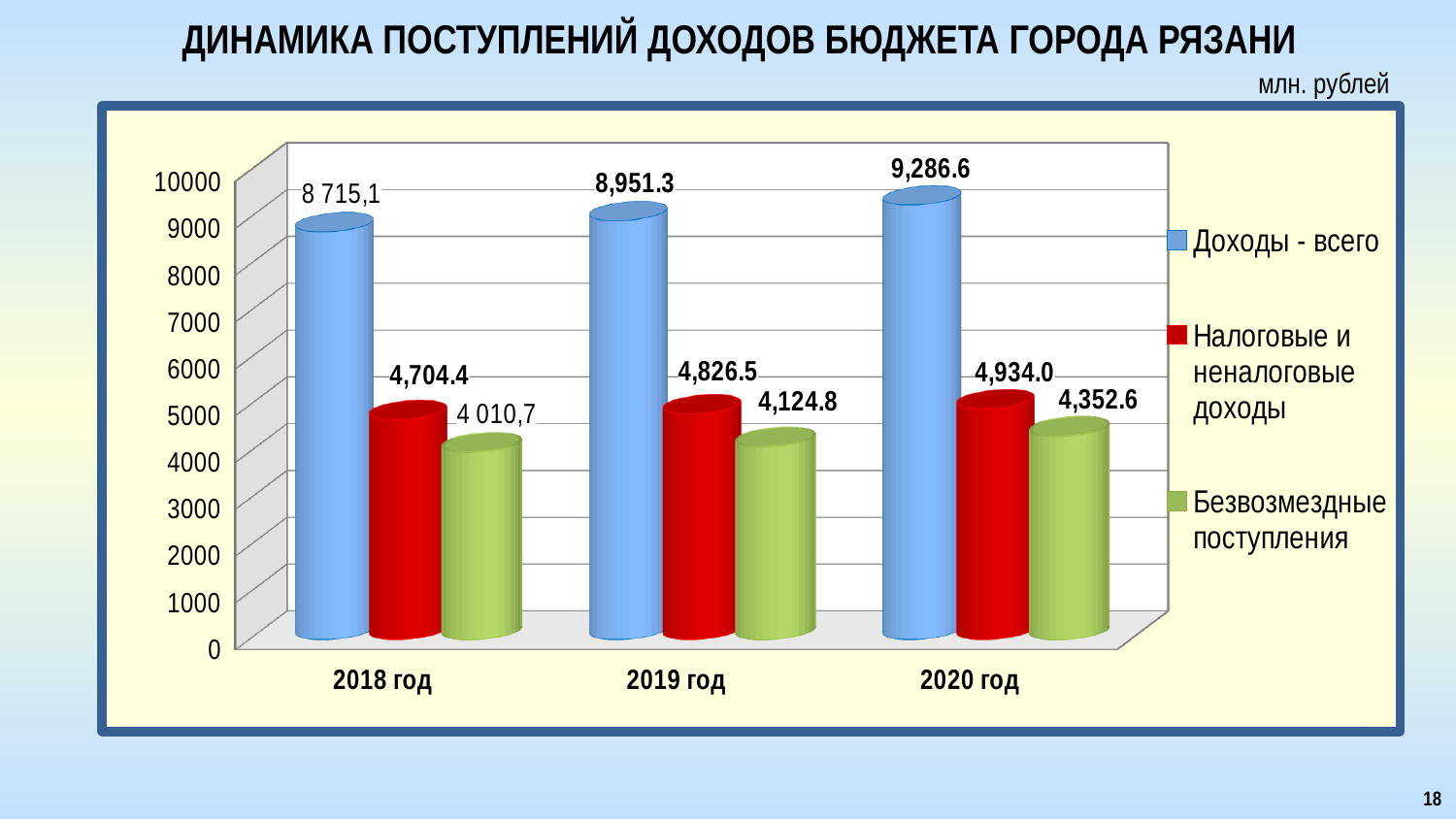
In which year is Безвозмездные поступления the lowest? 2018 год What is the value of Безвозмездные поступления for 2018 год? 4 010,7 How many series does the legend list? 3 Which is larger in 2019 год: Налоговые и неналоговые доходы or Безвозмездные поступления? Налоговые и неналоговые доходы In which year is Доходы - всего the highest? 2020 год What kind of chart is shown on the slide? Bar chart What is the value of Доходы - всего for 2019 год? 8,951.3 What is the difference between Доходы - всего in 2020 год and 2019 год? 335.3 What is the value of Налоговые и неналоговые доходы for 2020 год? 4,934.0 Does Доходы - всего rise or fall from 2018 год to 2020 год? Rise What is the difference between Безвозмездные поступления in 2020 год and 2019 год? 227.8 What is the value of Доходы - всего for 2018 год? 8 715,1